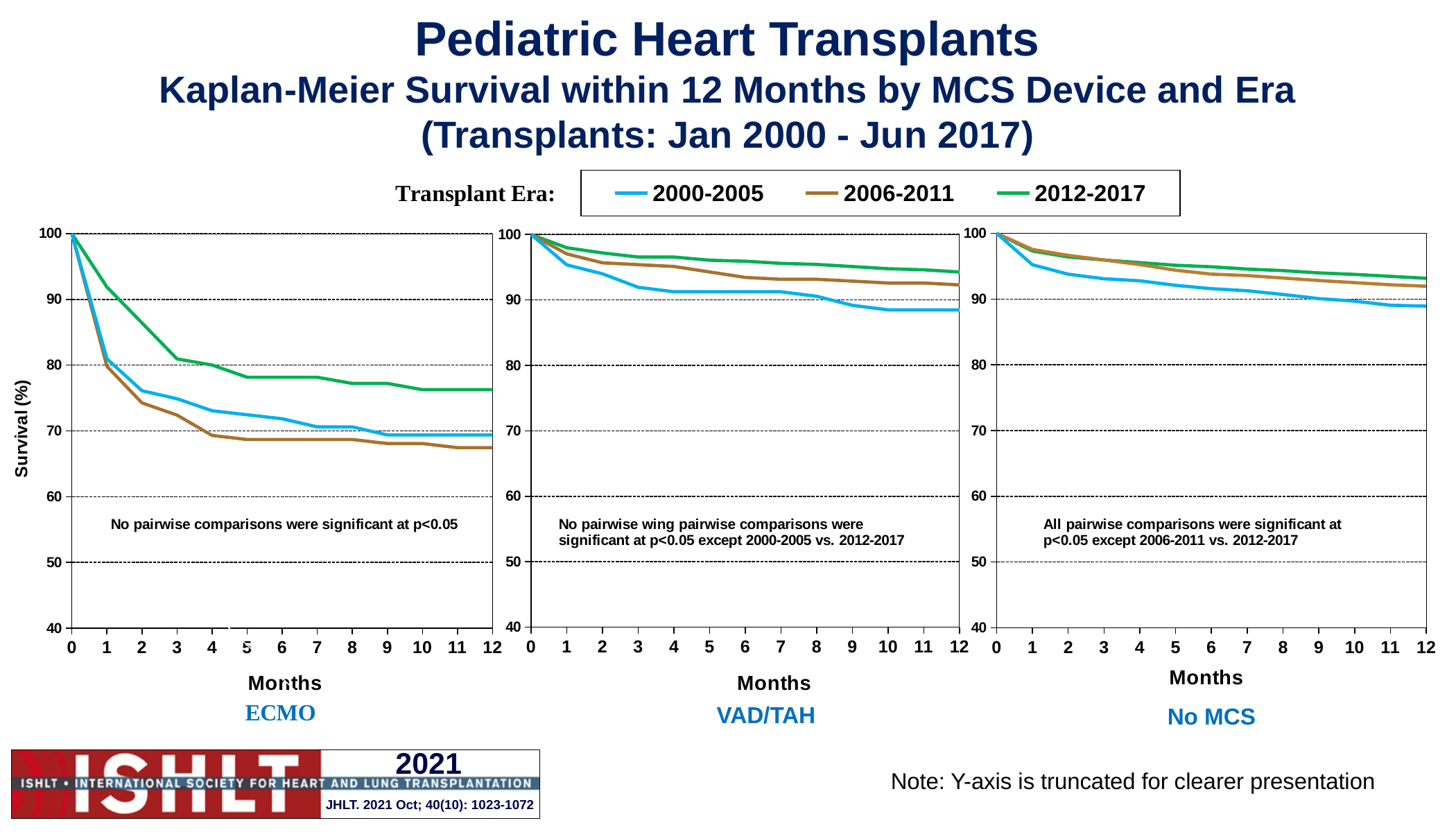
Which transplant era is shown in green in the legend? 2012-2017 In the VAD/TAH chart, is the 12-month survival for 2012-2017 greater or less than 90? greater In the ECMO chart, which transplant era has the highest survival at 12 months? 2012-2017 What kind of chart is the ECMO chart? line chart How many transplant eras does the legend list? 3 In the ECMO chart, is the 12-month survival for 2012-2017 greater or less than 70? greater In the VAD/TAH chart, which transplant era has the lowest survival at 12 months? 2000-2005 In the No MCS chart, which is higher at 12 months: survival for 2012-2017 or for 2000-2005? 2012-2017 In the ECMO chart, is the 12-month survival for 2006-2011 greater or less than 70? less In the ECMO chart, does survival rise or fall as months increase? fall What is the label of the y axis on the ECMO chart? Survival (%)